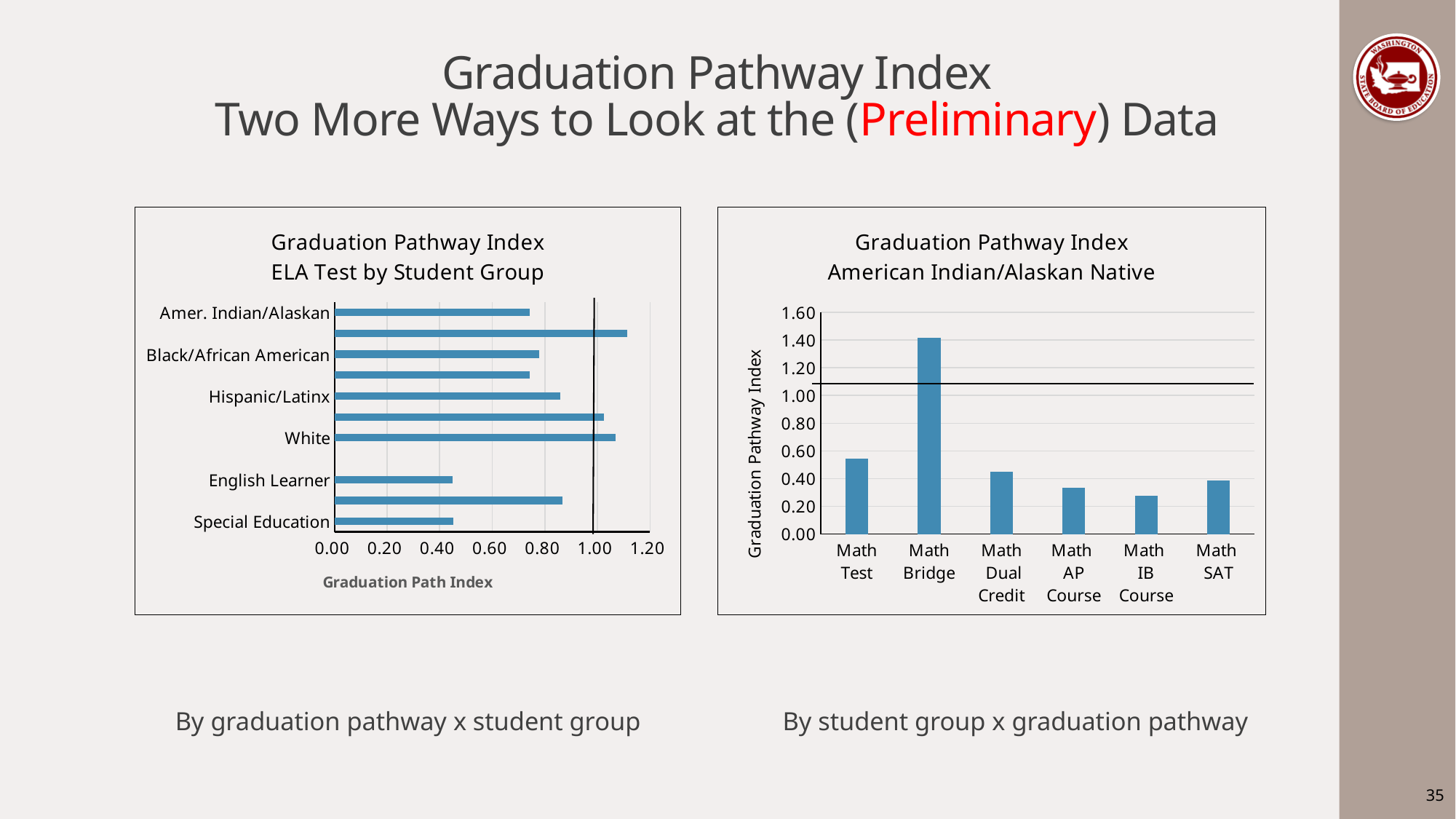
What is the y-axis title of the chart titled 'Graduation Pathway Index American Indian/Alaskan Native'? Graduation Pathway Index In the chart titled 'Graduation Pathway Index American Indian/Alaskan Native', which is larger, the value for Math Bridge or the value for Math Test? Math Bridge In the chart titled 'Graduation Pathway Index ELA Test by Student Group', which is larger, the value for White or the value for Special Education? White What kind of chart is the chart titled 'Graduation Pathway Index ELA Test by Student Group'? bar chart In the chart titled 'Graduation Pathway Index American Indian/Alaskan Native', which pathway has the highest value? Math Bridge In the chart titled 'Graduation Pathway Index American Indian/Alaskan Native', how many pathways are shown on the x axis? 6 In the chart titled 'Graduation Pathway Index American Indian/Alaskan Native', is the value for Math AP Course greater or less than 0.40? less In the chart titled 'Graduation Pathway Index ELA Test by Student Group', is the value for White greater or less than 1.00? greater In the chart titled 'Graduation Pathway Index American Indian/Alaskan Native', is the value for Math Test greater or less than 0.40? greater In the chart titled 'Graduation Pathway Index American Indian/Alaskan Native', which pathway has the lowest value? Math IB Course